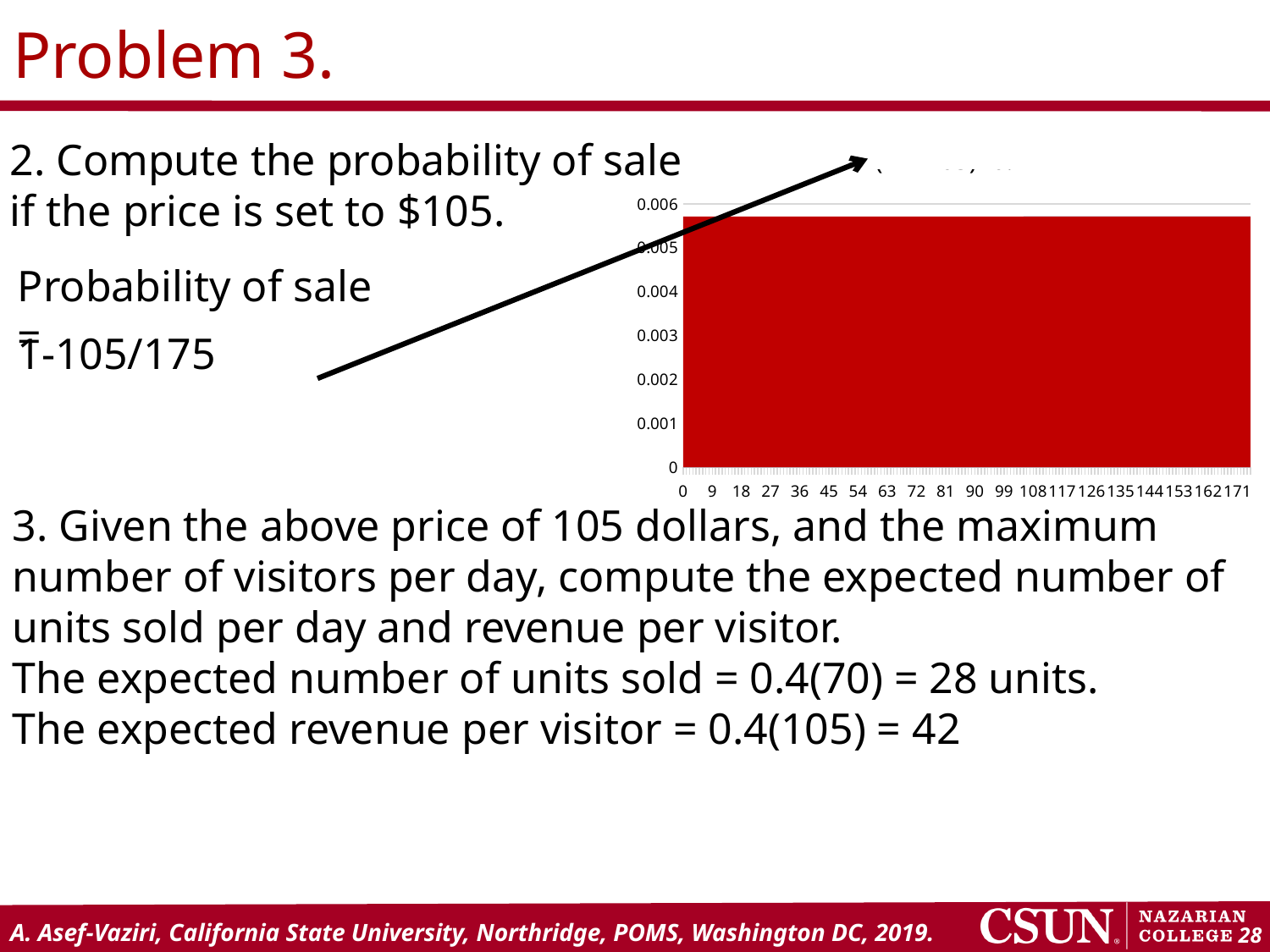
Do the bar heights rise, fall, or stay constant as you move along the horizontal axis? stay constant Is the value for 153 on the chart greater or less than 0.004? greater What is the last tick label shown on the horizontal axis of the chart? 171 Is the value for 36 on the chart greater or less than 0.005? greater Is the value for 0 on the chart greater or less than 0.003? greater How many tick labels are printed along the horizontal axis of the chart? 20 What is the highest tick value shown on the vertical axis of the chart? 0.006 What kind of chart is shown on the slide? area chart